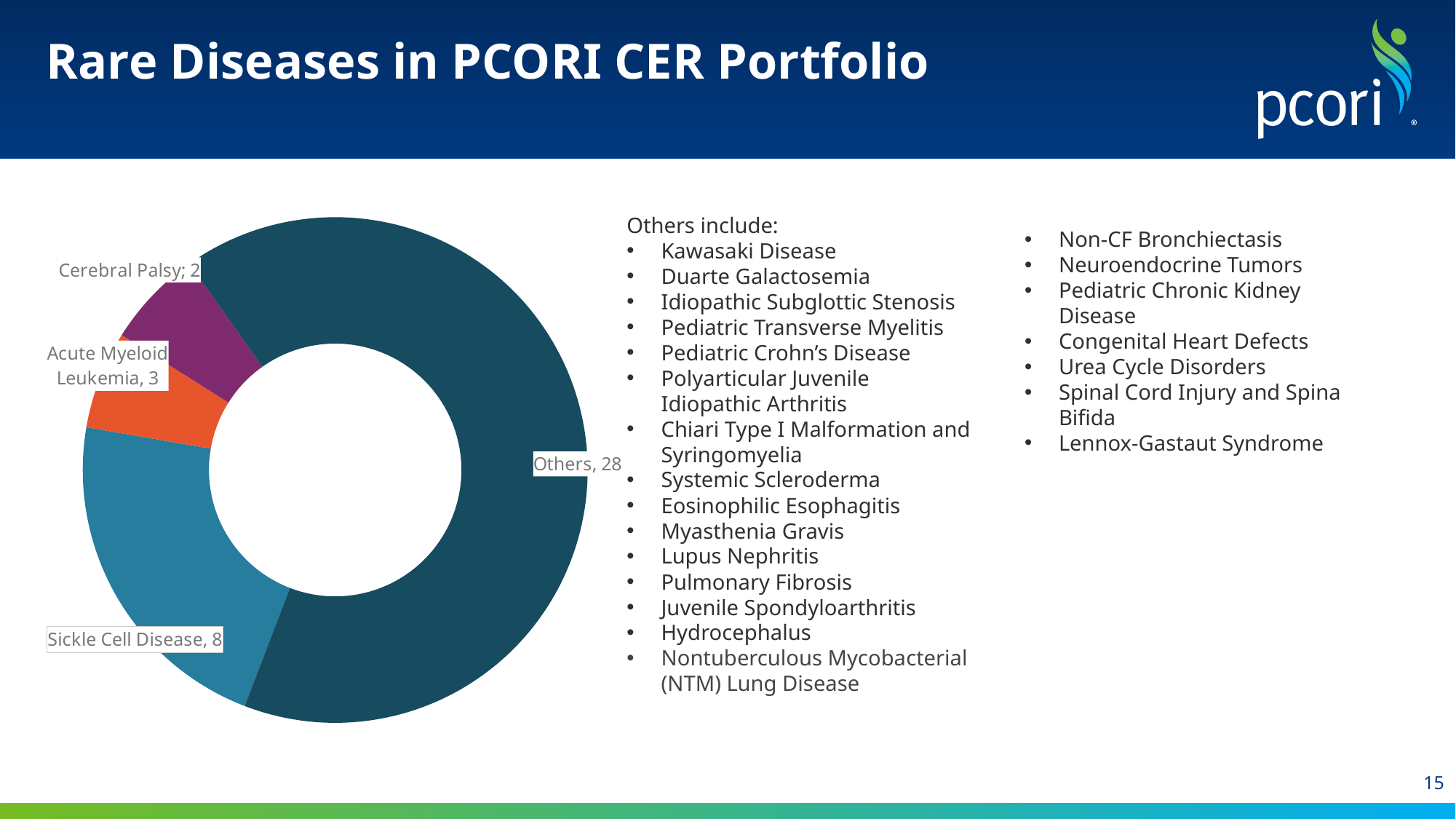
What is the total of all the slices in the donut chart? 41 Which category has the largest slice in the donut chart? Others What is the title of the slide containing the donut chart? Rare Diseases in PCORI CER Portfolio What is the difference between the values for Others and Sickle Cell Disease? 20 What kind of chart is shown on the slide? Pie chart (donut) Which is larger, the value for Sickle Cell Disease or the value for Acute Myeloid Leukemia? Sickle Cell Disease What is the value for Sickle Cell Disease in the donut chart? 8 What is the value for Others in the donut chart? 28 Which category has the smallest slice in the donut chart? Cerebral Palsy What is the value for Acute Myeloid Leukemia in the donut chart? 3 What is the value for Cerebral Palsy in the donut chart? 2 How many slices does the donut chart have? 4